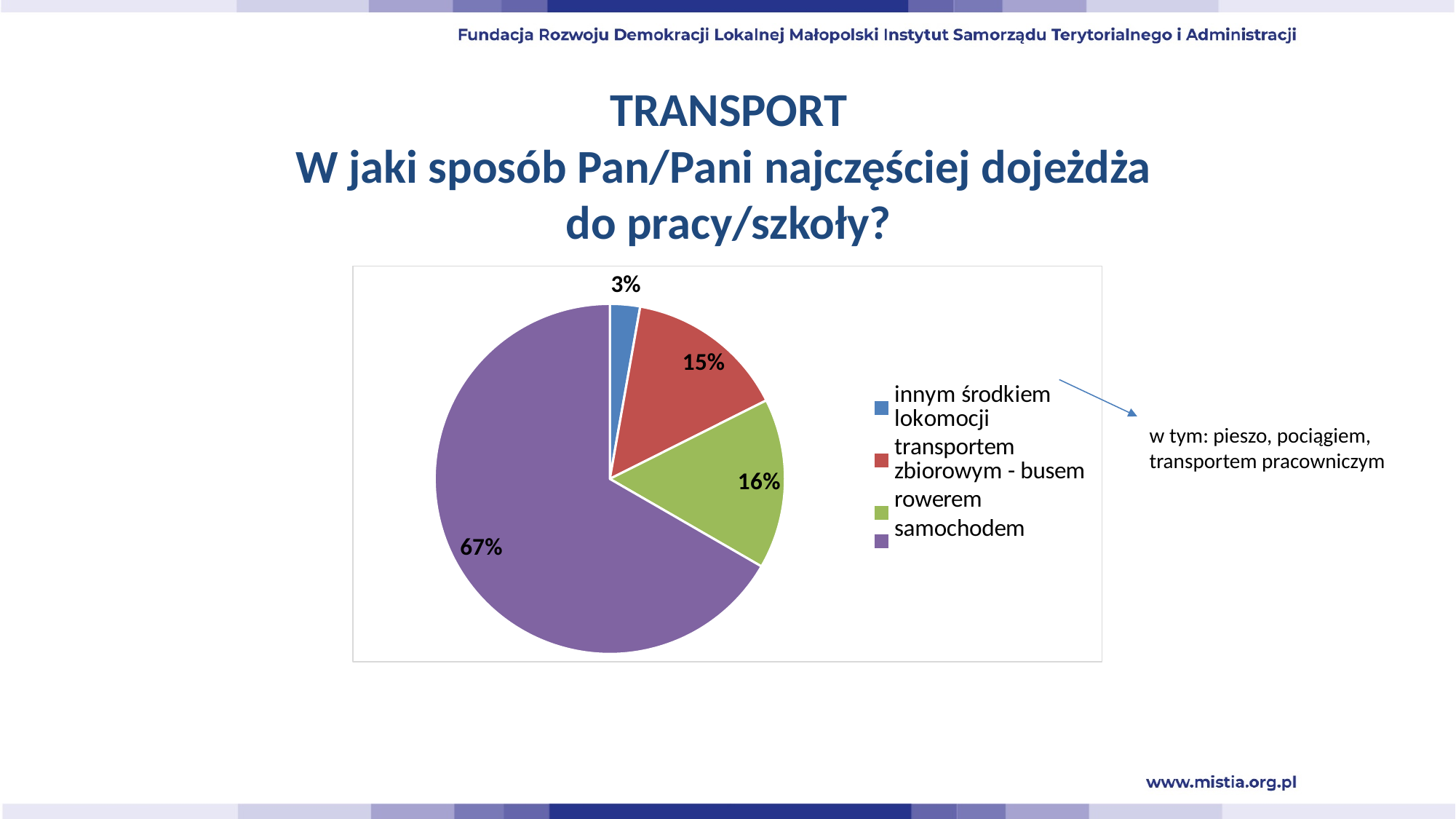
What is the difference in percentage points between samochodem and rowerem? 51 Which category has the smallest share of the pie? innym środkiem lokomocji What colour is the slice for samochodem? purple What share of respondents commute by bicycle (rowerem)? 16% What is the difference in percentage points between rowerem and transportem zbiorowym - busem? 1 What share of respondents commute by car (samochodem)? 67% Which category has the largest share of the pie? samochodem What kind of chart is shown on the slide? pie chart What share of respondents commute by other means of transport (innym środkiem lokomocji)? 3% Which is larger: the share for samochodem or the share for transportem zbiorowym - busem? samochodem How many categories does the pie chart have? 4 What share of respondents commute by public transport - bus (transportem zbiorowym - busem)? 15%